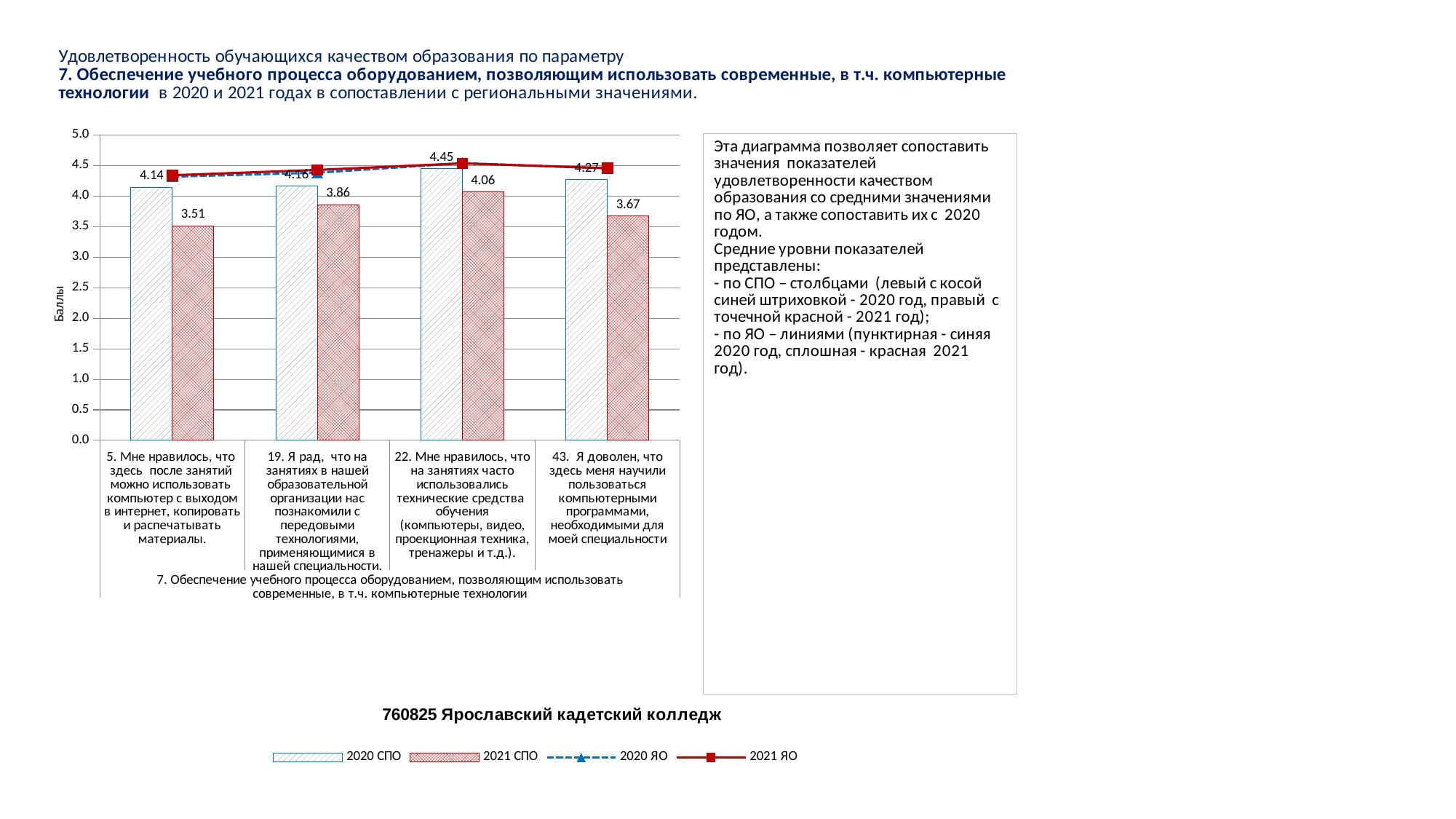
What is the label of the vertical axis? Баллы How many statements (categories) are shown on the x axis? 4 For statement 43, which is larger: the 2020 СПО value or the 2021 СПО value? 2020 СПО What kind of chart is shown on the slide? Combined bar and line chart Which statement has the highest 2021 СПО value? 22. Мне нравилось, что на занятиях часто использовались технические средства обучения What is the 2021 СПО value for statement 5 ("Мне нравилось, что здесь после занятий можно использовать компьютер с выходом в интернет")? 3.51 What is the difference between the 2020 СПО and 2021 СПО values for statement 19? 0.30 Is the 2021 ЯО value for statement 5 greater or less than 4.0? greater Which statement has the lowest 2021 СПО value? 5. Мне нравилось, что здесь после занятий можно использовать компьютер с выходом в интернет What is the 2020 СПО value for statement 22 ("Мне нравилось, что на занятиях часто использовались технические средства обучения")? 4.45 How many series does the legend list? 4 What is the 2021 СПО value for statement 43 ("Я доволен, что здесь меня научили пользоваться компьютерными программами")? 3.67